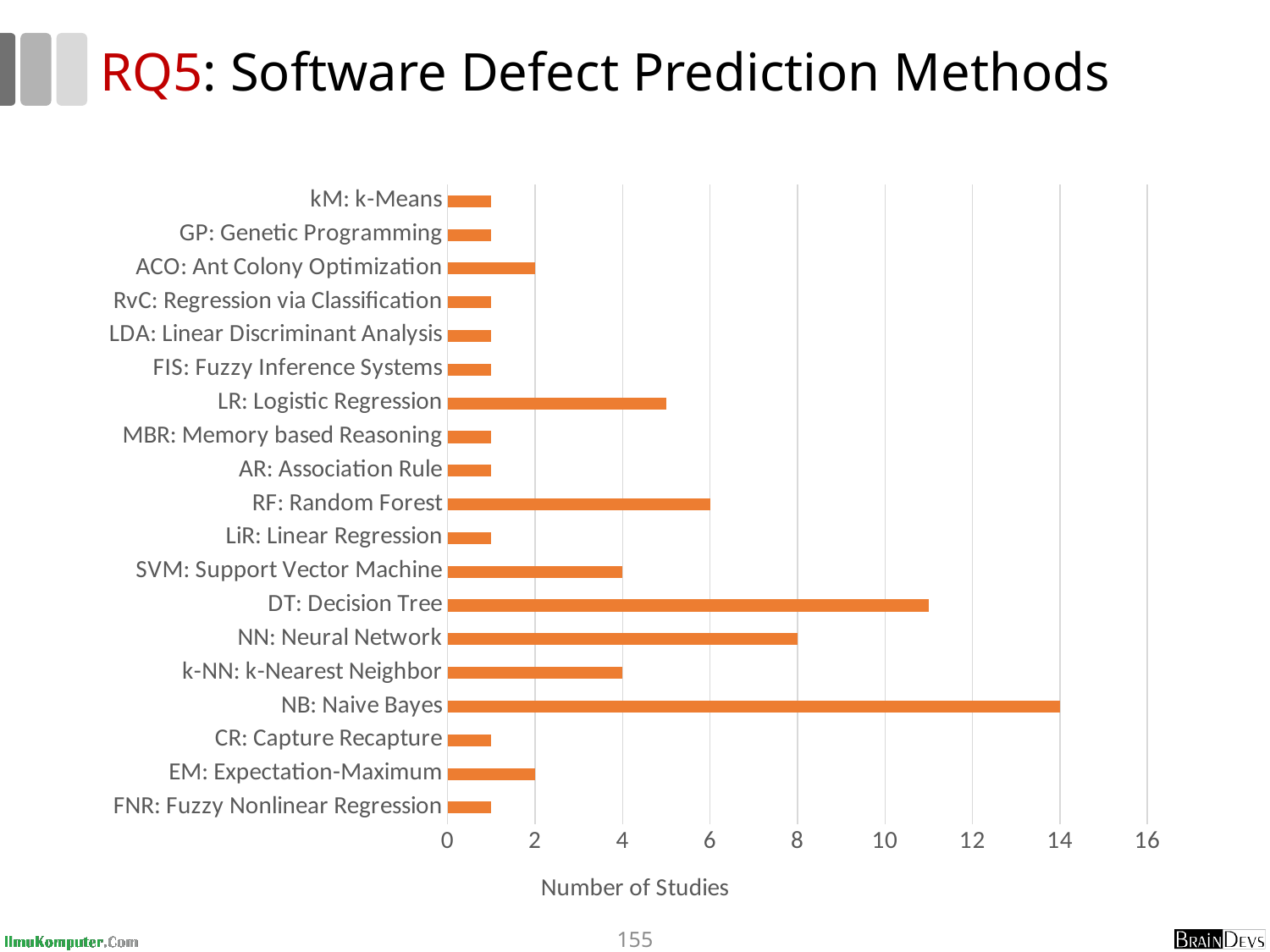
What is the number of studies for SVM: Support Vector Machine? 4 What is the number of studies for ACO: Ant Colony Optimization? 2 Is the number of studies for DT: Decision Tree greater or less than 10? greater What is the label of the horizontal axis? Number of Studies Which has more studies, DT: Decision Tree or NN: Neural Network? DT: Decision Tree How many methods are listed on the chart? 19 What is the number of studies for NN: Neural Network? 8 Which method has the highest number of studies? NB: Naive Bayes What is the number of studies for NB: Naive Bayes? 14 What type of chart is shown on the slide? bar chart What is the difference in number of studies between NB: Naive Bayes and NN: Neural Network? 6 Is the number of studies for RF: Random Forest greater or less than 8? less